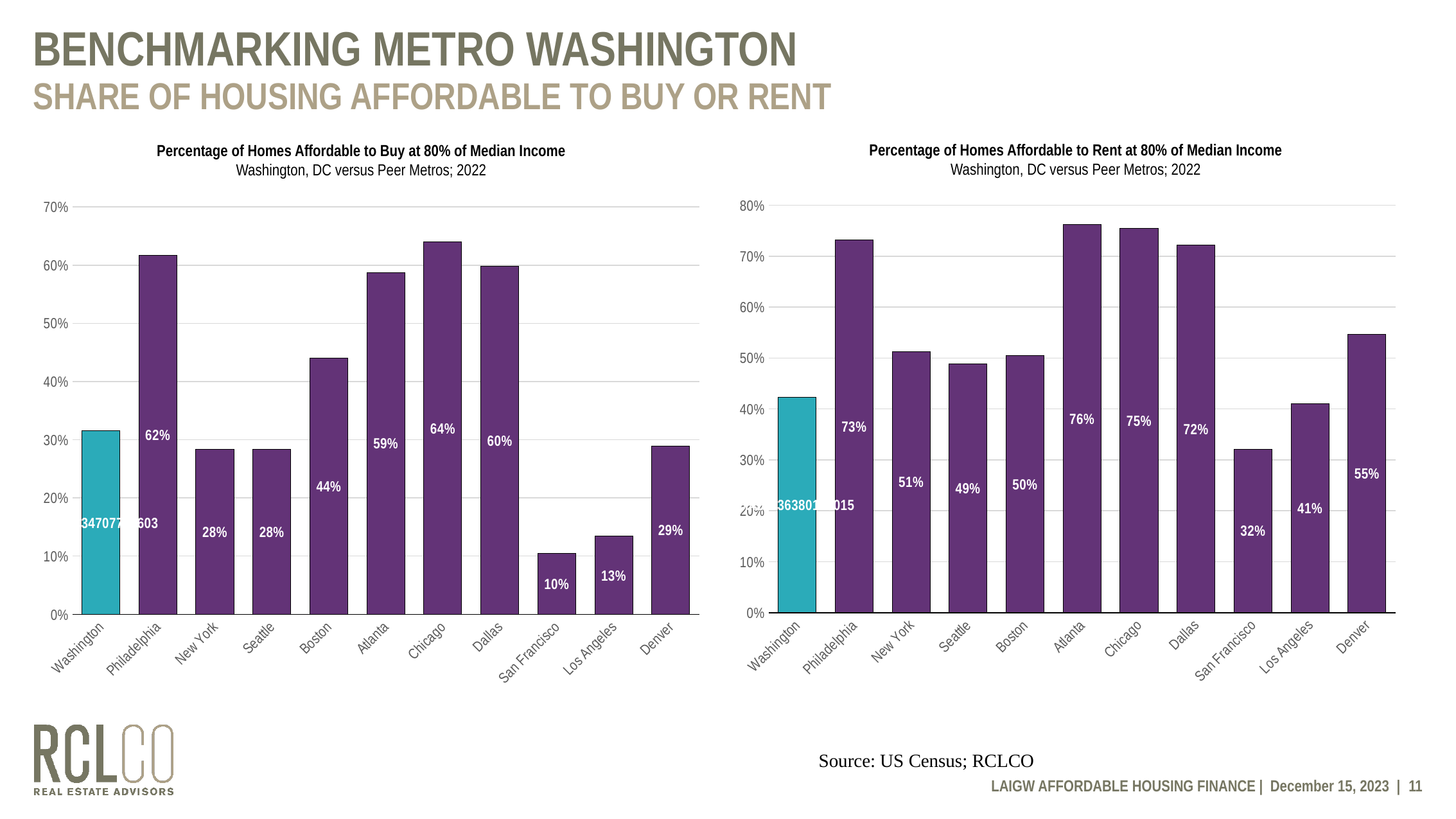
In the 'Percentage of Homes Affordable to Rent' chart, which metro has the lowest value? San Francisco In the 'Percentage of Homes Affordable to Buy' chart, is the value for Washington greater or less than 30%? greater In the 'Percentage of Homes Affordable to Buy' chart, which metro has the highest value? Chicago In the 'Percentage of Homes Affordable to Rent' chart, what is the difference between Atlanta and Dallas? 4% In the 'Percentage of Homes Affordable to Buy' chart, what is the difference between Philadelphia and Boston? 18% In the 'Percentage of Homes Affordable to Rent' chart, what is the value for Denver? 55% In the 'Percentage of Homes Affordable to Buy' chart, which metro has the lowest value? San Francisco How many metros are shown in the 'Percentage of Homes Affordable to Buy' chart? 11 What type of chart is the 'Percentage of Homes Affordable to Rent' chart? Bar chart In the 'Percentage of Homes Affordable to Rent' chart, is the value for Washington greater or less than 40%? greater In the 'Percentage of Homes Affordable to Buy' chart, what is the value for Chicago? 64% In the 'Percentage of Homes Affordable to Rent' chart, which is larger, Los Angeles or Seattle? Seattle